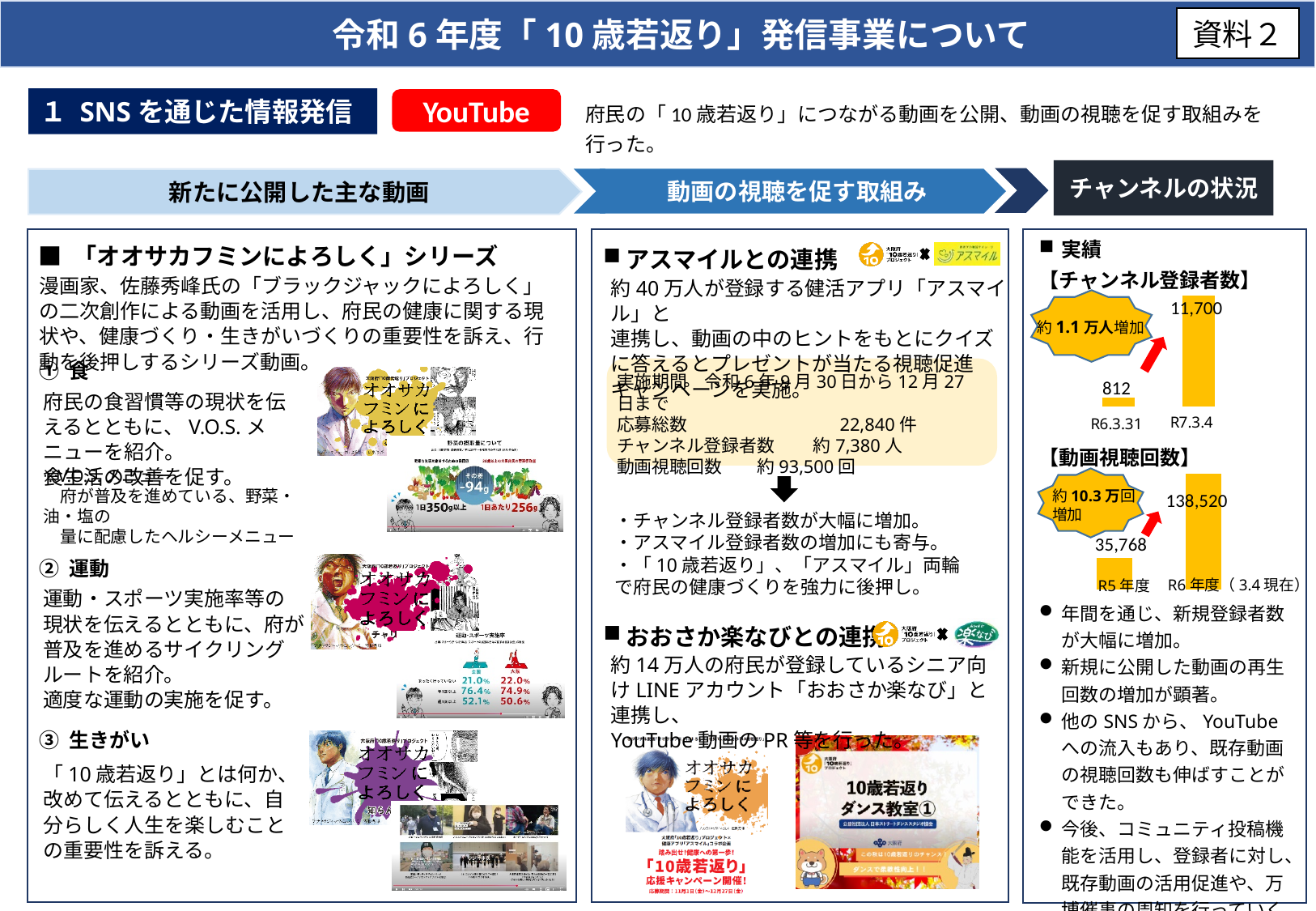
What kind of chart is the 【動画視聴回数】 chart? bar chart In the 【動画視聴回数】 chart, what is the value for R5年度? 35,768 In the 【動画視聴回数】 chart, what is the difference between the R6年度 value and the R5年度 value? 102,752 In the 【チャンネル登録者数】 chart, which category has the higher value? R7.3.4 In the 【動画視聴回数】 chart, is the value for R6年度 larger or smaller than the value for R5年度? larger How many bars are shown in the 【チャンネル登録者数】 chart? 2 In the 【チャンネル登録者数】 chart, what is the difference between the R7.3.4 value and the R6.3.31 value? 10,888 In the 【チャンネル登録者数】 chart, what is the value for R6.3.31? 812 In the 【動画視聴回数】 chart, which category has the lower value? R5年度 In the 【チャンネル登録者数】 chart, what is the value for R7.3.4? 11,700 What increase does the callout next to the 【チャンネル登録者数】 chart state? 約1.1万人増加 In the 【動画視聴回数】 chart, what is the value for R6年度（3.4現在）? 138,520